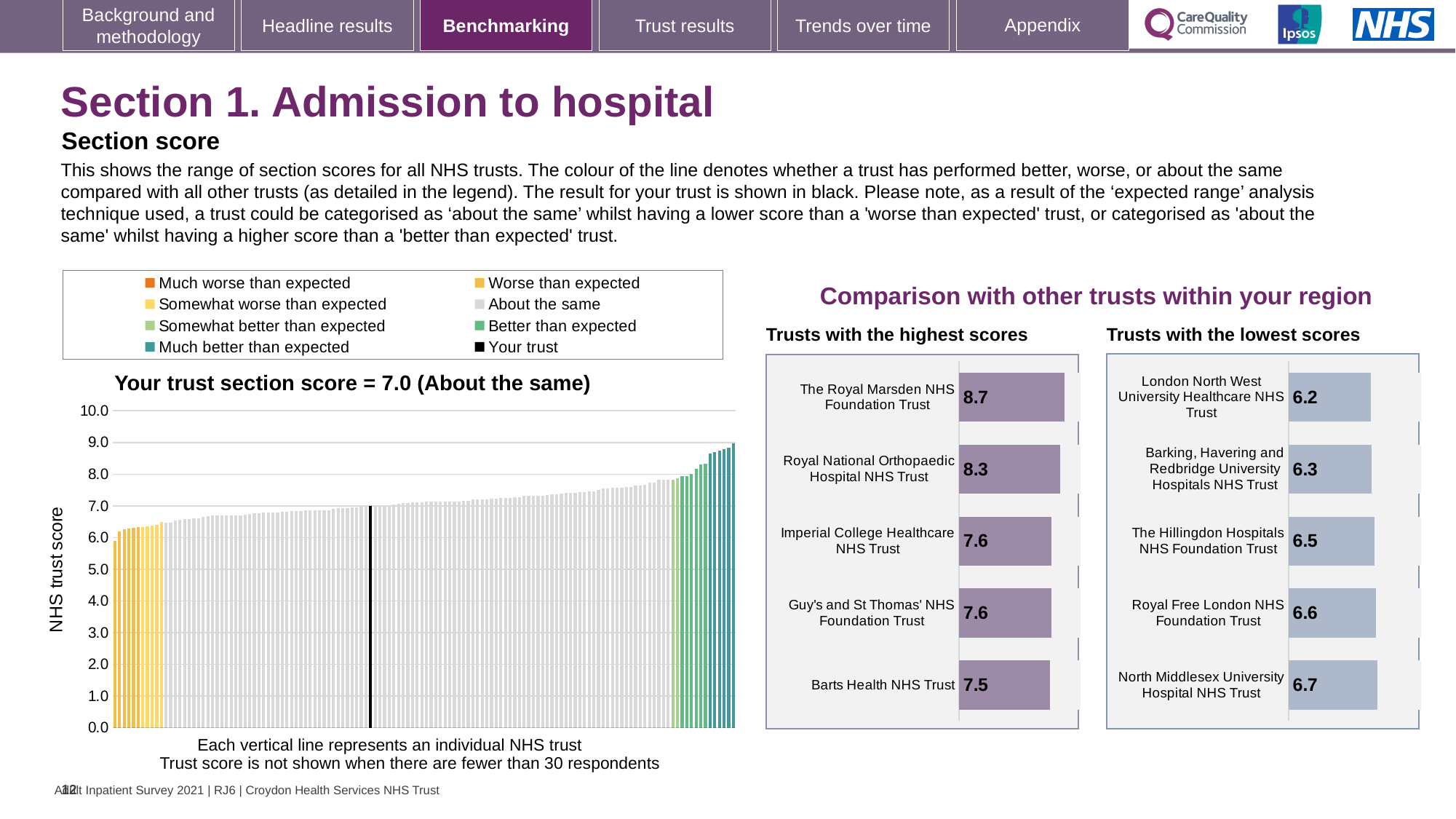
In the 'Trusts with the lowest scores' chart, which trust has the lowest score? London North West University Healthcare NHS Trust In the 'Trusts with the lowest scores' chart, what is the difference between the scores of North Middlesex University Hospital NHS Trust and London North West University Healthcare NHS Trust? 0.5 According to the title of the 'Your trust section score' chart, what is your trust's section score? 7.0 In the 'Trusts with the highest scores' chart, what is the score for The Royal Marsden NHS Foundation Trust? 8.7 In the 'Trusts with the lowest scores' chart, what is the score for The Hillingdon Hospitals NHS Foundation Trust? 6.5 In the 'Your trust section score' chart, do the bar heights rise or fall from left to right? rise In the 'Trusts with the lowest scores' chart, which trust has the highest score shown? North Middlesex University Hospital NHS Trust How many entries does the legend above the 'Your trust section score' chart list? 8 In the 'Trusts with the highest scores' chart, which has the larger score: The Royal Marsden NHS Foundation Trust or Royal National Orthopaedic Hospital NHS Trust? The Royal Marsden NHS Foundation Trust How many trusts are listed in the 'Trusts with the lowest scores' chart? 5 In the 'Trusts with the highest scores' chart, what is the difference between the scores of The Royal Marsden NHS Foundation Trust and Barts Health NHS Trust? 1.2 In the 'Trusts with the highest scores' chart, which trust has the lowest score shown? Barts Health NHS Trust